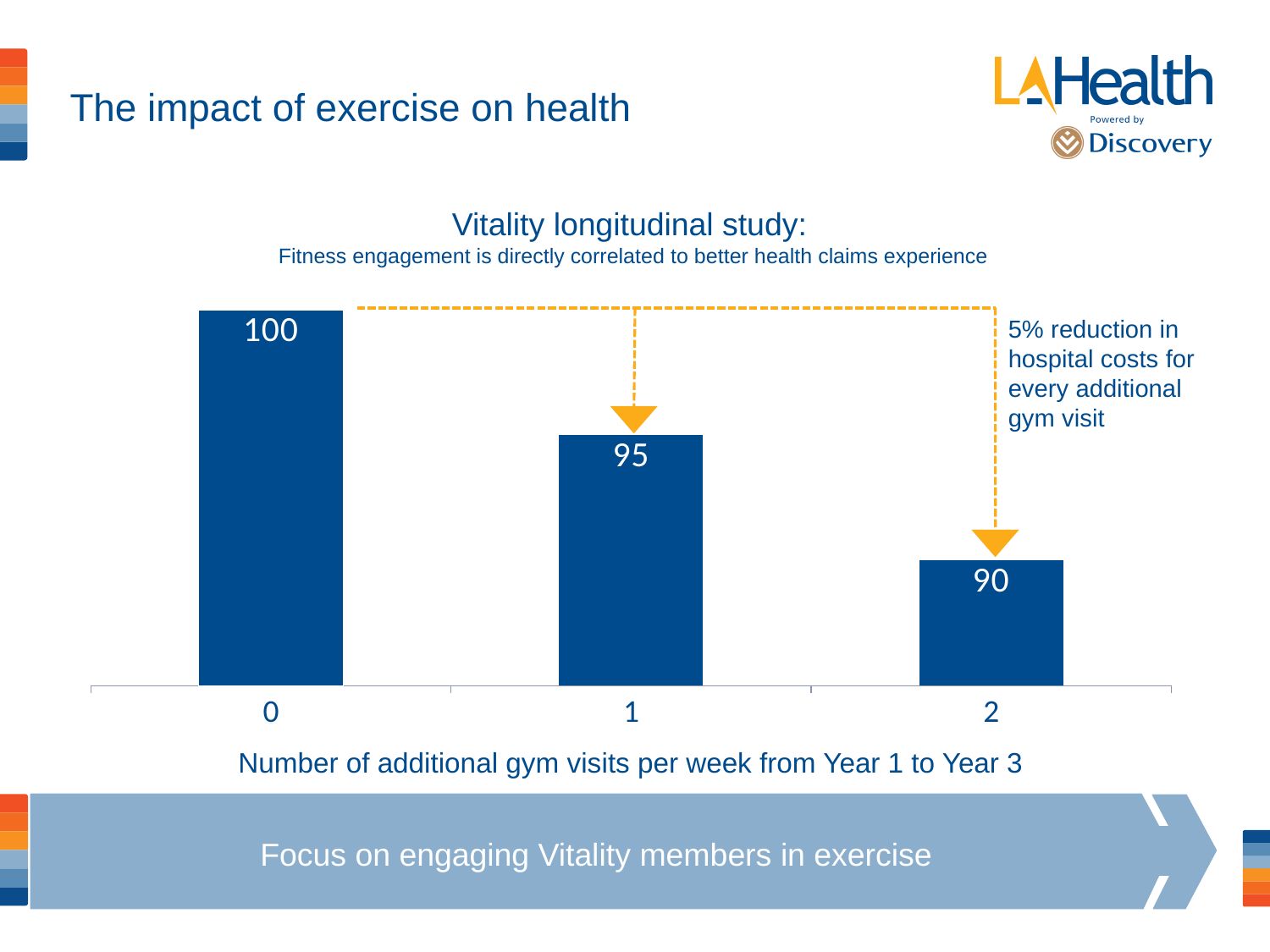
What is the difference between the values for 0 and 2 additional gym visits? 10 What is the x-axis label of the chart? Number of additional gym visits per week from Year 1 to Year 3 Do the values rise or fall as the number of additional gym visits increases? Fall What kind of chart is shown on the slide? Bar chart How many bars are shown in the chart? 3 Which category has the lowest value? 2 Which is larger, the value for 1 or the value for 2 additional gym visits? 1 What is the value for 0 additional gym visits per week? 100 What is the difference between the values for 0 and 1 additional gym visits? 5 What is the value for 1 additional gym visit per week? 95 What is the value for 2 additional gym visits per week? 90 Which category has the highest value? 0